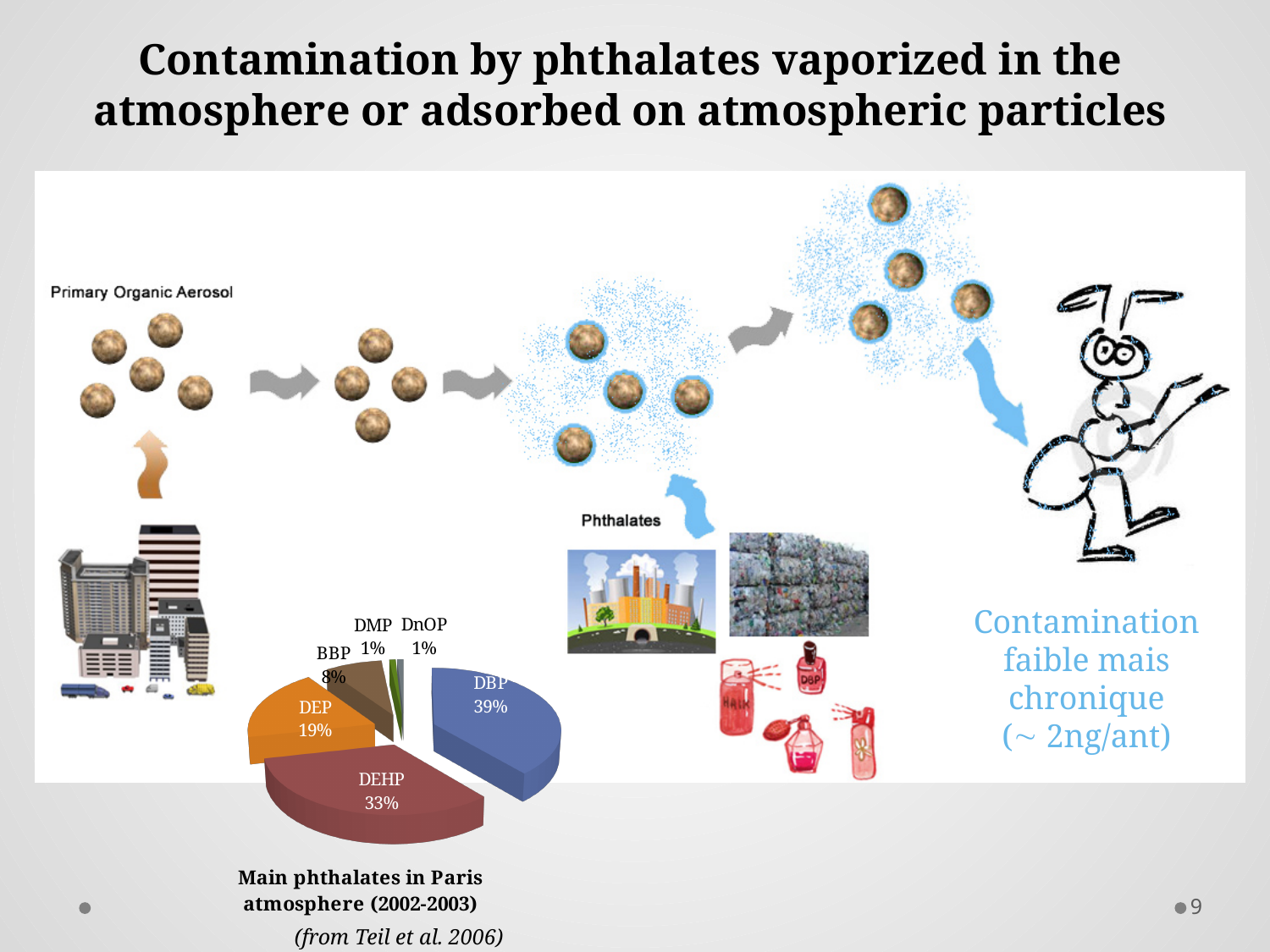
How many phthalate categories are shown in the pie chart? 6 Which slice is larger, DEHP or DEP? DEHP What is the difference in percentage points between the DBP and DEHP slices? 6 What is the difference in percentage points between the DEP and BBP slices? 11 What share of the pie chart does BBP represent? 8% What is the caption of the pie chart? Main phthalates in Paris atmosphere (2002-2003) What share of the pie chart does DEHP represent? 33% What share of the pie chart does DEP represent? 19% What type of chart is shown on the slide? Pie chart Which phthalate has the largest share in the pie chart? DBP What share of the pie chart does DBP represent? 39%